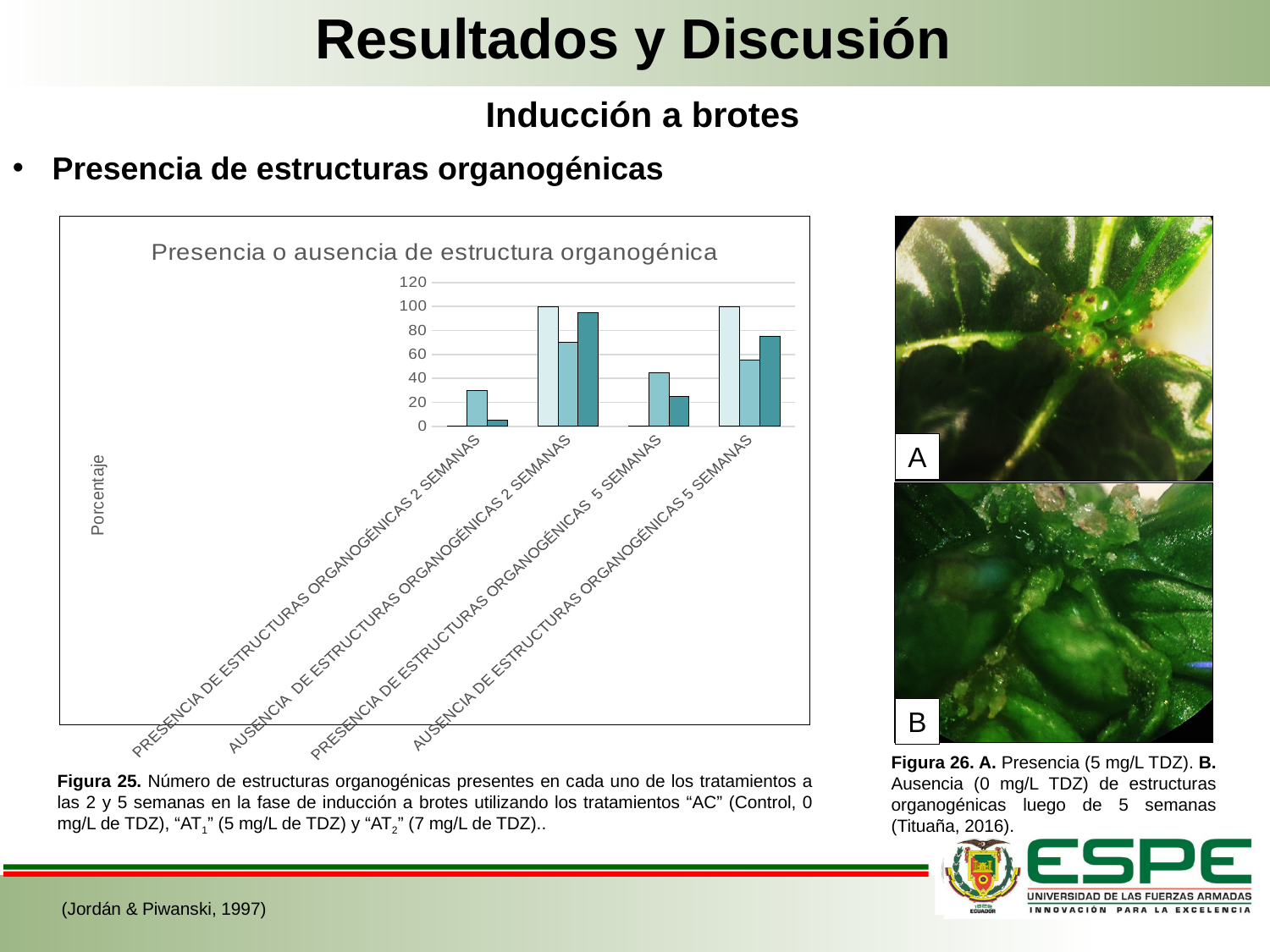
Is the value of the middle-shade bar for "PRESENCIA DE ESTRUCTURAS ORGANOGÉNICAS 2 SEMANAS" greater or less than 20? greater Is the value of the middle-shade bar for "PRESENCIA DE ESTRUCTURAS ORGANOGÉNICAS 5 SEMANAS" greater or less than 60? less How many categories are shown on the x axis of the chart? 4 Is the value of the darkest bar for "PRESENCIA DE ESTRUCTURAS ORGANOGÉNICAS 5 SEMANAS" greater or less than 40? less In the category "AUSENCIA DE ESTRUCTURAS ORGANOGÉNICAS 2 SEMANAS", which is taller: the lightest bar or the middle-shade bar? the lightest bar How many bars are plotted for each category in the chart? 3 What is the label on the vertical axis of the chart? Porcentaje What kind of chart is shown on the slide? bar chart What is the title of the chart? Presencia o ausencia de estructura organogénica Which category has the shortest middle-shade bar? PRESENCIA DE ESTRUCTURAS ORGANOGÉNICAS 2 SEMANAS